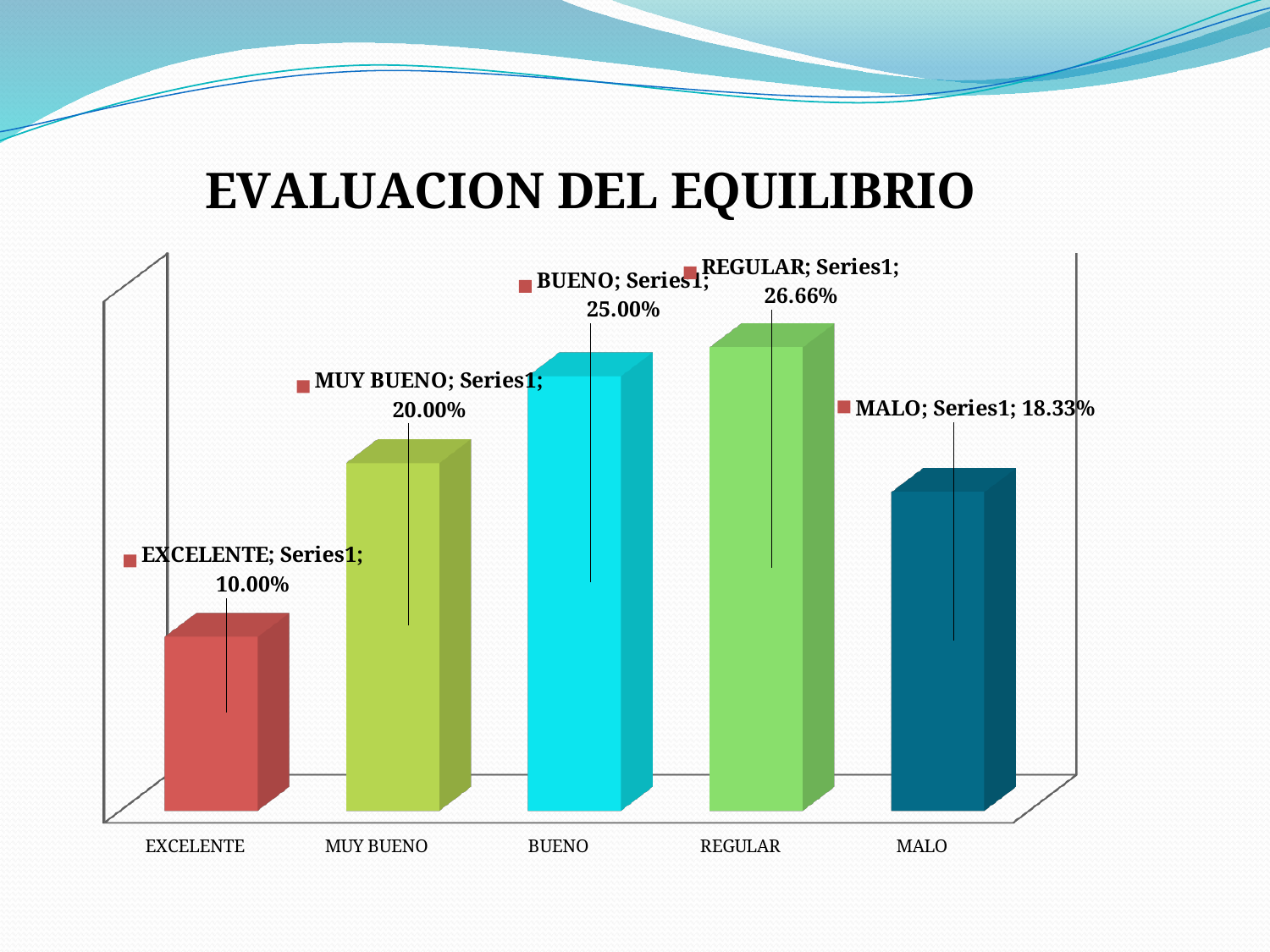
Which category has the lowest value? EXCELENTE What is the difference between the values for MALO and EXCELENTE? 8.33% What is the value for EXCELENTE? 10.00% Which is larger, the value for MALO or the value for MUY BUENO? MUY BUENO Which category has the highest value? REGULAR What is the difference between the values for BUENO and MUY BUENO? 5.00% What is the value for BUENO? 25.00% What is the value for MUY BUENO? 20.00% What is the value for MALO? 18.33% What is the value for REGULAR? 26.66% What is the title of the chart? EVALUACION DEL EQUILIBRIO How many categories are shown in the chart? 5